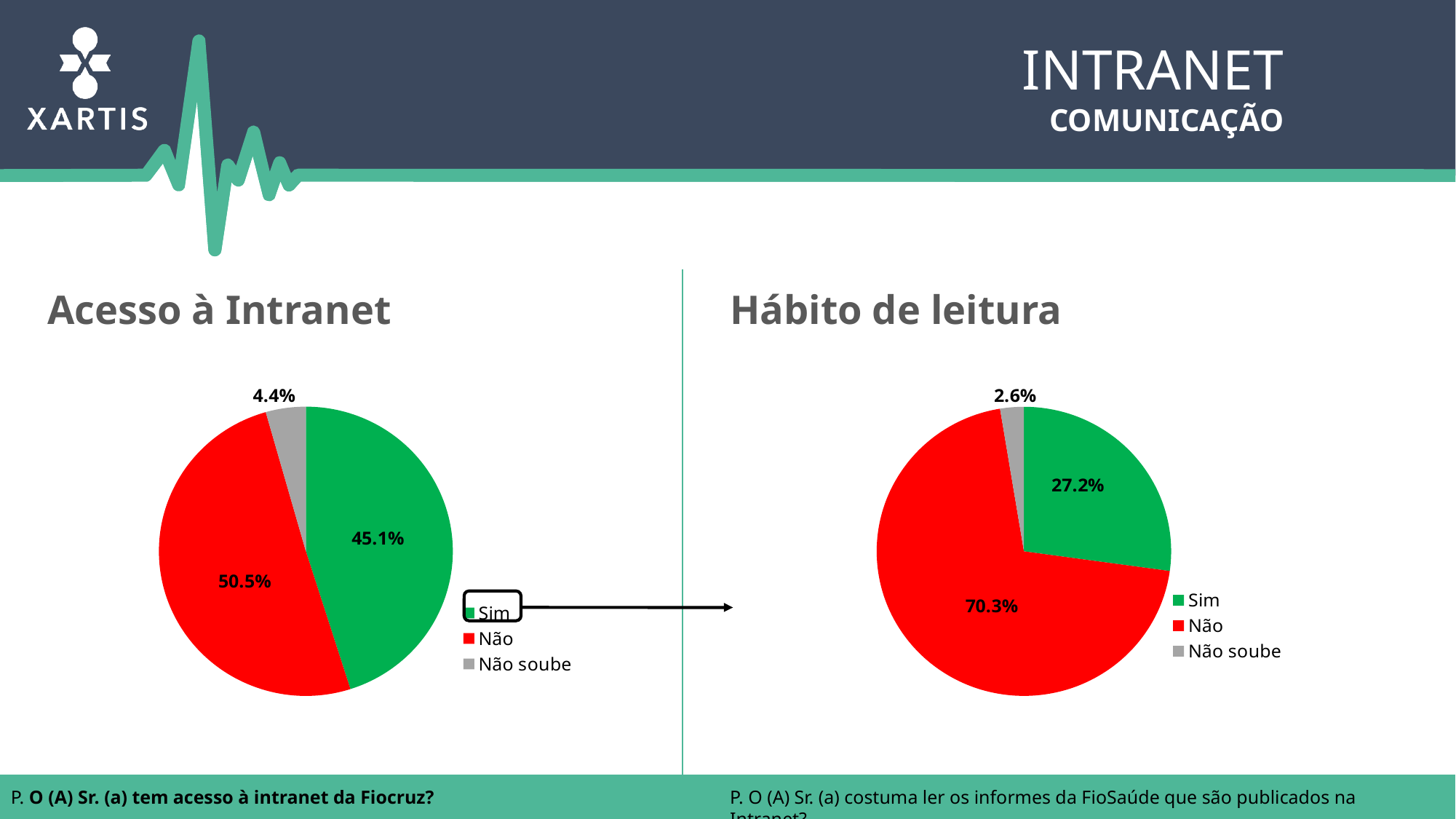
In the 'Acesso à Intranet' chart, what is the value for Não? 50.5% In the 'Hábito de leitura' chart, what is the value for Não? 70.3% In the 'Hábito de leitura' chart, which category has the largest share? Não In the 'Acesso à Intranet' chart, which category has the smallest share? Não soube What kind of chart is the 'Acesso à Intranet' chart? Pie chart In the 'Hábito de leitura' chart, what is the value for Sim? 27.2% In the 'Acesso à Intranet' chart, which is larger, Sim or Não? Não In the 'Acesso à Intranet' chart, what is the value for Não soube? 4.4% In the 'Hábito de leitura' chart, what is the difference between Não and Sim? 43.1% In the 'Acesso à Intranet' chart, what is the value for Sim? 45.1% How many slices does the 'Hábito de leitura' chart have? 3 In the 'Hábito de leitura' chart, what colour is the Não slice? Red